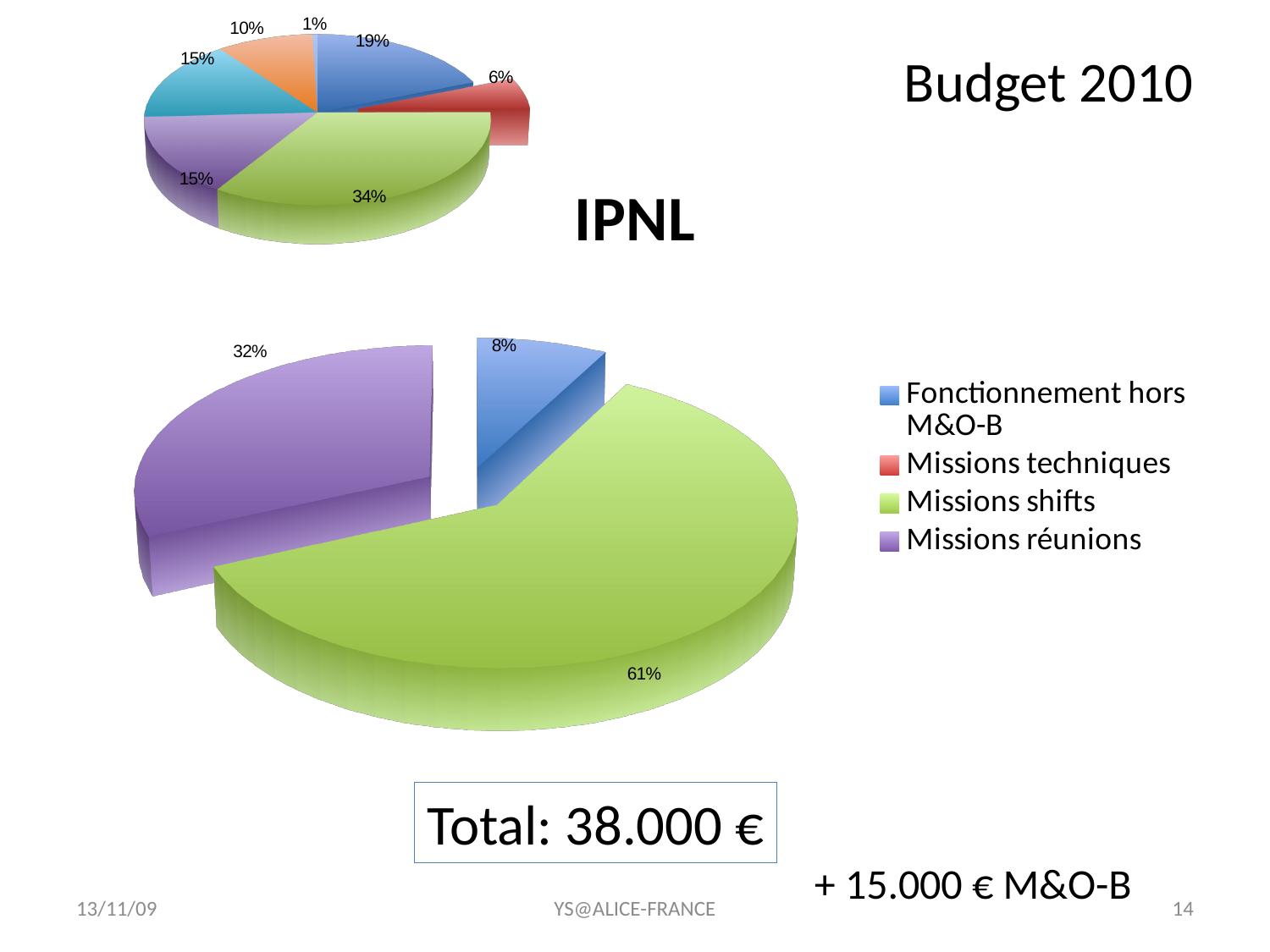
How many slices are labelled on the small pie chart at the top left of the slide? 7 On the large IPNL pie chart, what share is shown for Missions réunions? 32% On the large IPNL pie chart, which is larger: Missions réunions or Fonctionnement hors M&O-B? Missions réunions On the large IPNL pie chart, what is the difference in percentage points between Missions shifts and Missions réunions? 29 On the large IPNL pie chart, what is the difference in percentage points between Missions réunions and Fonctionnement hors M&O-B? 24 What kind of chart is the large IPNL chart? pie chart On the large IPNL pie chart, what share is shown for Missions shifts? 61% On the large IPNL pie chart, what share is shown for Fonctionnement hors M&O-B? 8% On the large IPNL pie chart, which category has the largest slice? Missions shifts On the large IPNL pie chart, what colour is the Missions shifts slice? green How many entries does the legend of the large IPNL pie chart list? 4 On the small pie chart at the top left of the slide, what is the largest percentage label shown? 34%